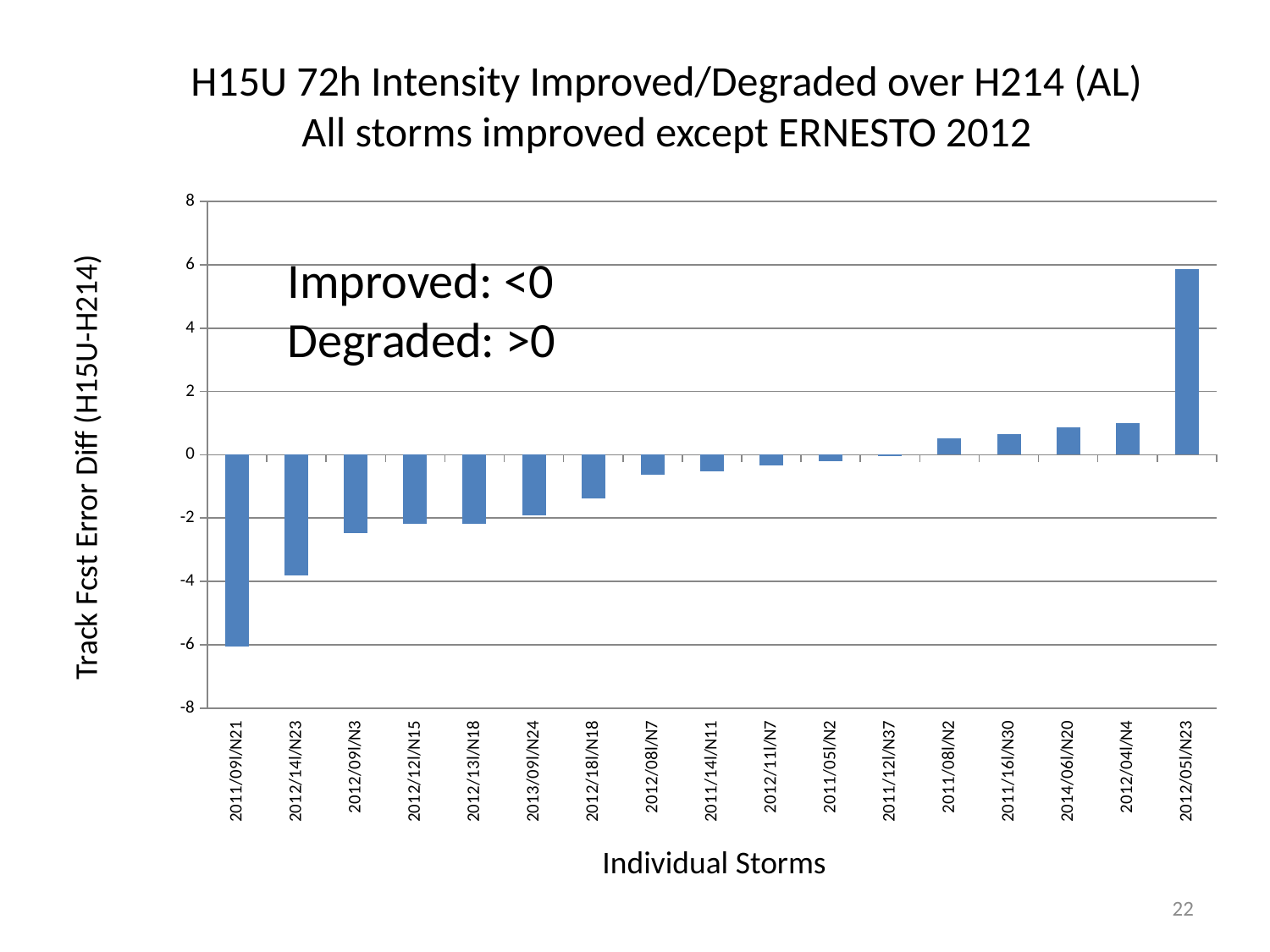
Which has the larger value, 2011/08l/N2 or 2012/04l/N4? 2012/04l/N4 How many individual storms are plotted along the x axis? 17 What is the title of the y axis? Track Fcst Error Diff (H15U-H214) Which storm has the lowest (most negative) track forecast error difference? 2011/09l/N21 Is the value for 2011/09l/N21 greater or less than -4? less Is the value for 2012/14l/N23 greater or less than -2? less Do the bar values rise or fall moving from left to right along the x axis? rise What kind of chart is shown on the slide? bar chart Which storm has the highest (most positive) track forecast error difference? 2012/05l/N23 Which has the larger value, 2012/14l/N23 or 2012/09l/N3? 2012/09l/N3 Is the value for 2012/05l/N23 greater or less than 4? greater